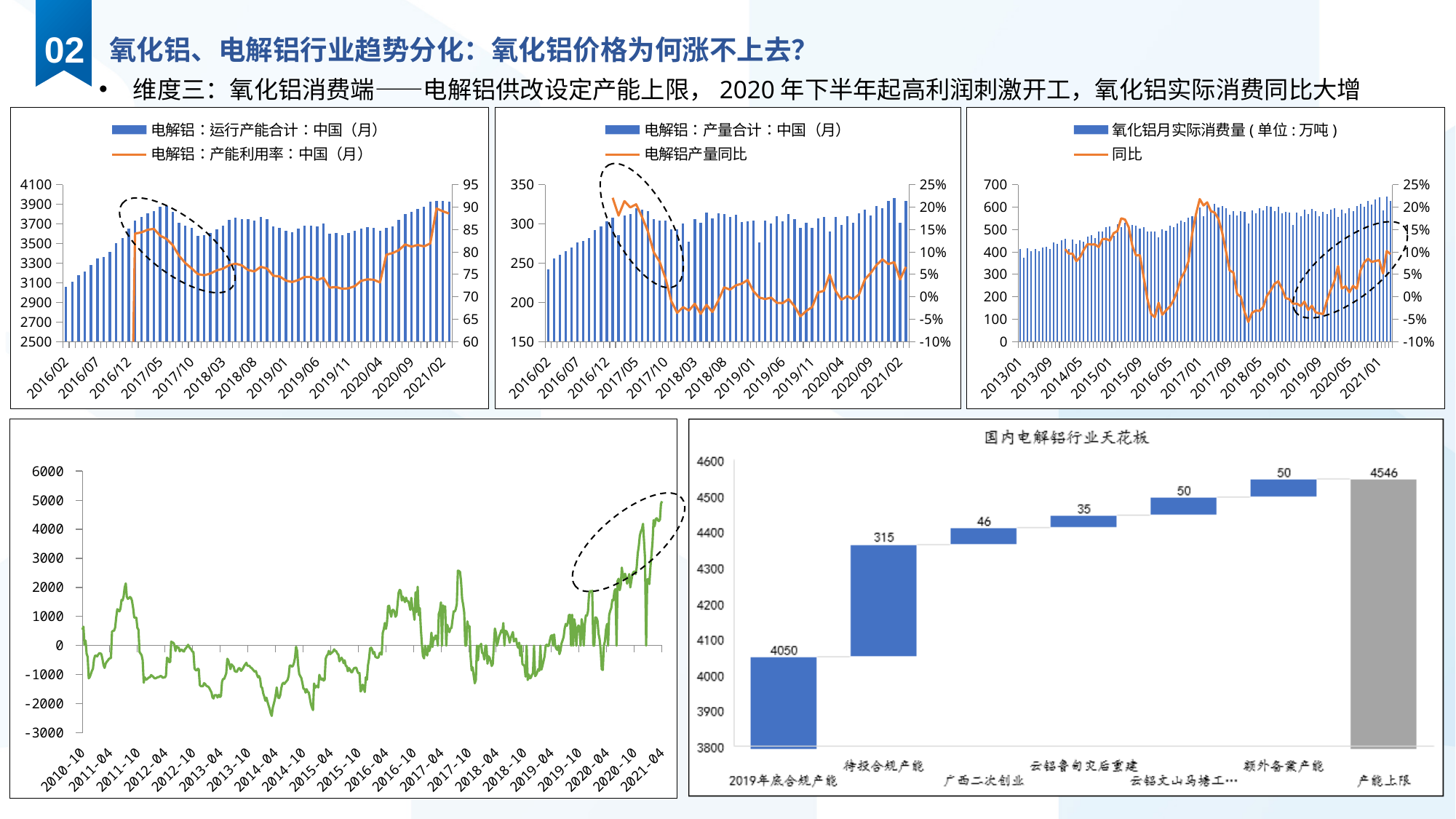
What kind of chart is the bottom-left chart with the green series? line chart In the chart titled 国内电解铝行业天花板, what is the value labelled for 广西二次创业? 46 In the chart titled 国内电解铝行业天花板, what is the value labelled for 云铝鲁甸灾后重建? 35 What is the second legend entry of the top-right chart? 同比 In the chart titled 国内电解铝行业天花板, what is the value labelled for 产能上限? 4546 How many series does the legend of the top-left chart list? 2 In the chart titled 国内电解铝行业天花板, what is the difference between the values for 待投合规产能 and 广西二次创业? 269 In the chart titled 国内电解铝行业天花板, which is larger, the value for 广西二次创业 or the value for 额外备案产能? 额外备案产能 In the chart titled 国内电解铝行业天花板, what is the value labelled for 2019年底合规产能? 4050 In the chart titled 国内电解铝行业天花板, which category has the smallest labelled value? 云铝鲁甸灾后重建 In the chart titled 国内电解铝行业天花板, what is the value labelled for 待投合规产能? 315 How many categories are shown on the x axis of the chart titled 国内电解铝行业天花板? 7